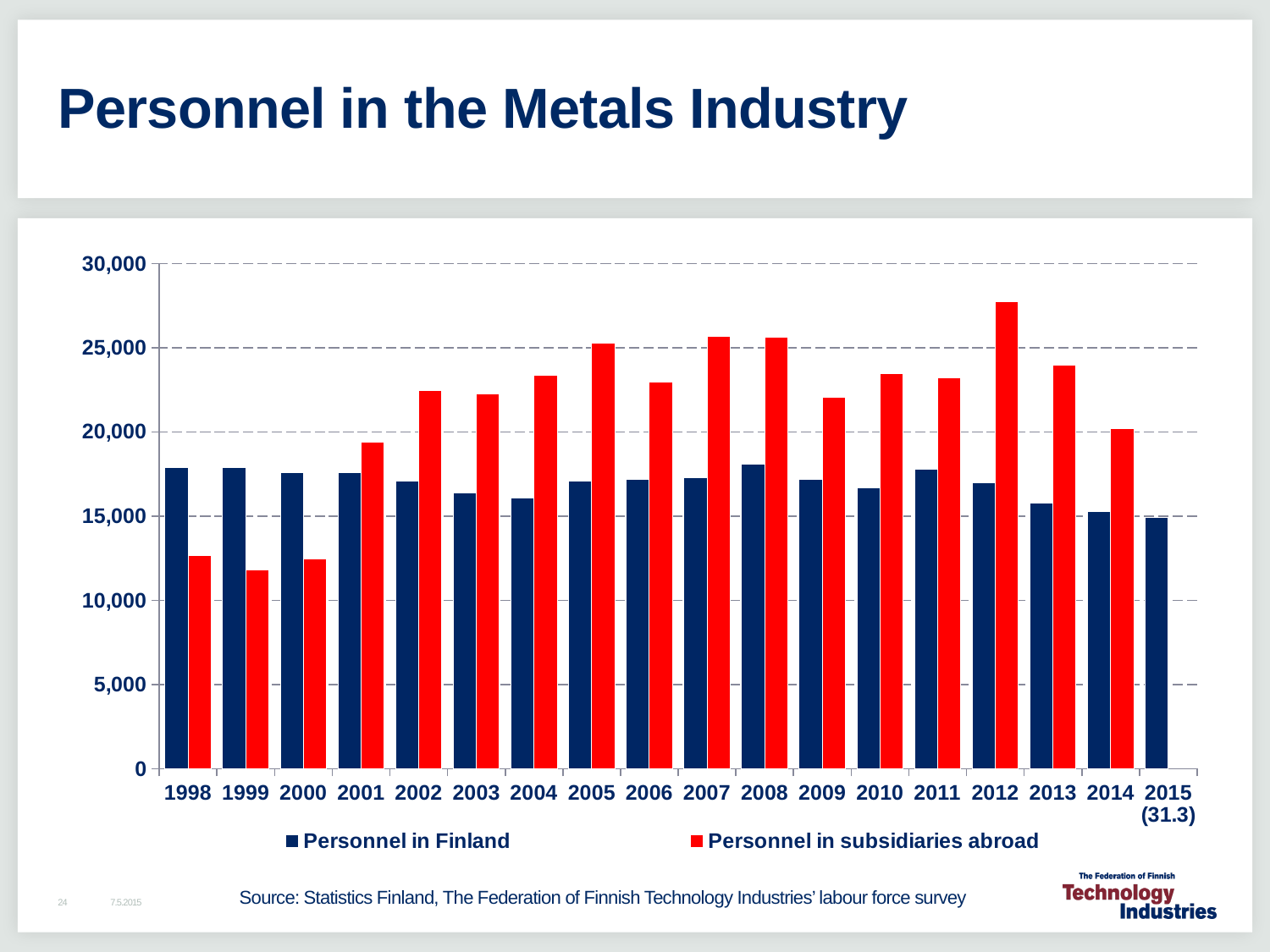
In which year is Personnel in subsidiaries abroad lowest? 1999 How many years (categories) are shown on the x axis? 18 In 1998, which is larger: Personnel in Finland or Personnel in subsidiaries abroad? Personnel in Finland Is the value for Personnel in subsidiaries abroad in 2001 greater or less than 20,000? less What kind of chart is shown on the slide? bar chart Does Personnel in Finland rise or fall from 2011 to 2015 (31.3)? fall In which year is Personnel in Finland lowest? 2015 (31.3) Is the value for Personnel in subsidiaries abroad in 2012 greater or less than 25,000? greater In 2012, which is larger: Personnel in Finland or Personnel in subsidiaries abroad? Personnel in subsidiaries abroad How many series does the legend list? 2 In which year is Personnel in subsidiaries abroad highest? 2012